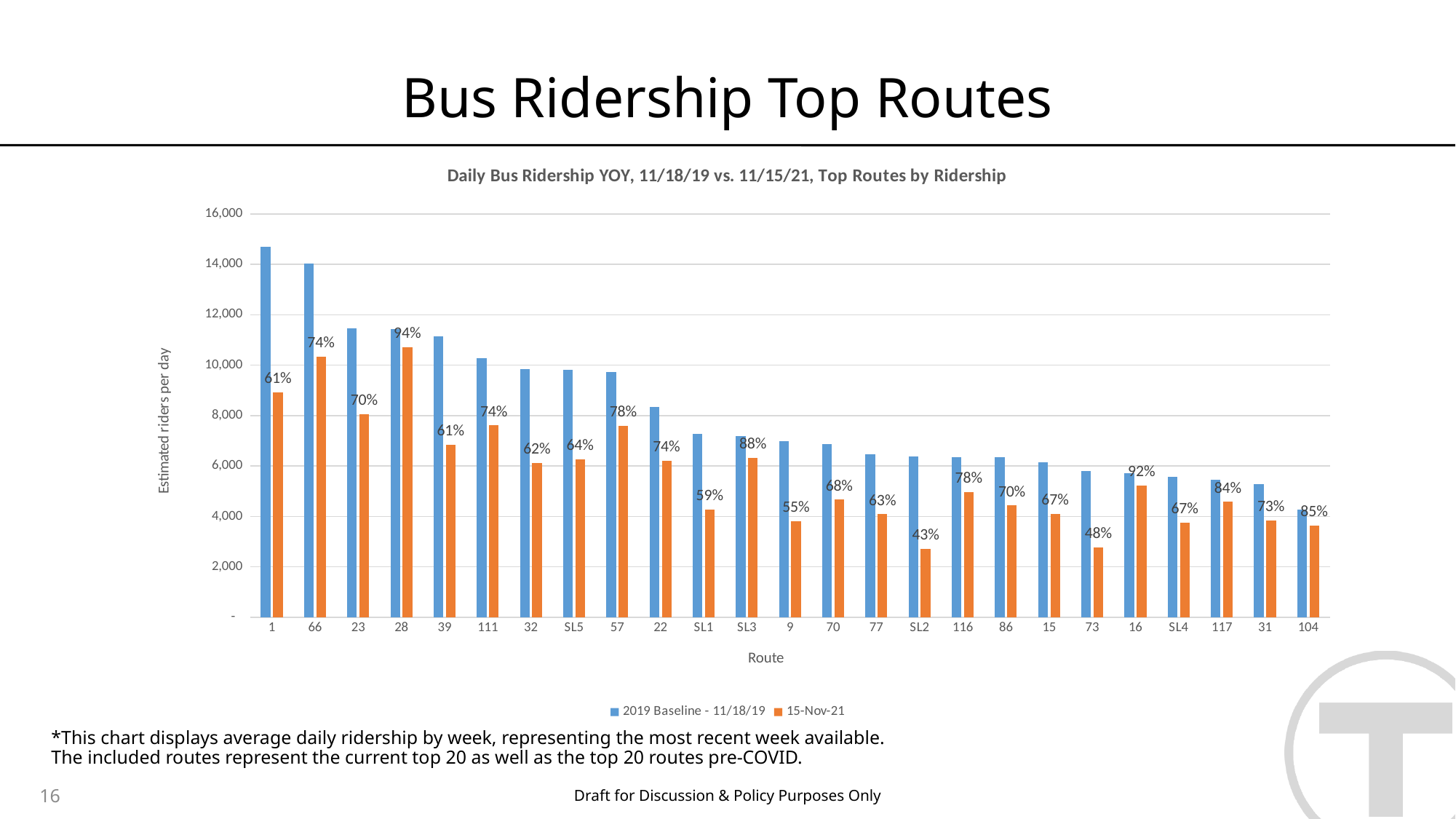
What kind of chart is shown on the slide? bar chart Which route has the highest 2019 Baseline - 11/18/19 value? 1 Which route has the highest percentage label? 28 How many series does the chart's legend list? 2 Is the 15-Nov-21 value for route SL2 greater or less than 4,000? less Which route has the lowest percentage label? SL2 What percentage label is shown for route SL2? 43% How many routes are shown on the x axis of the chart? 25 Do the 2019 Baseline - 11/18/19 values rise or fall from left to right along the x axis? fall Is the 2019 Baseline - 11/18/19 value for route 1 greater or less than 14,000? greater What percentage label is shown for route 16? 92% What percentage label is shown for route 28? 94%